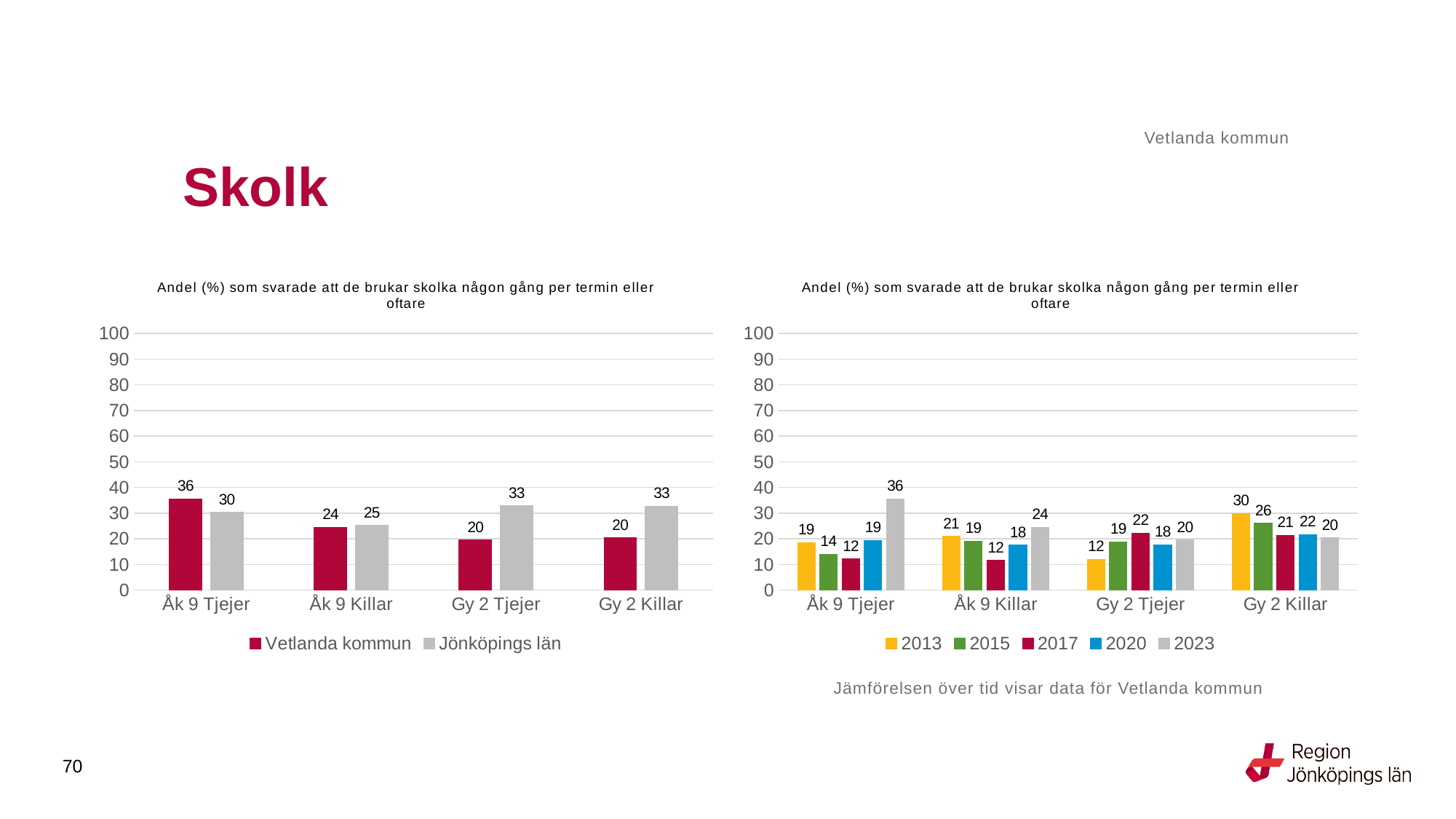
In the left chart, what is the difference between Jönköpings län and Vetlanda kommun for Gy 2 Tjejer? 13 In the left chart, which is larger for Åk 9 Tjejer: Vetlanda kommun or Jönköpings län? Vetlanda kommun In the right chart, what is the value for 2013 for Gy 2 Killar? 30 What type of chart is the right chart? Bar chart In the right chart, what is the difference between 2023 and 2017 for Åk 9 Tjejer? 24 In the left chart, what is the value for Jönköpings län for Gy 2 Killar? 33 How many series does the legend of the right chart list? 5 In the right chart, what is the value for 2023 for Åk 9 Tjejer? 36 How many categories are shown on the x axis of the left chart? 4 In the left chart, which category has the highest value for Vetlanda kommun? Åk 9 Tjejer In the right chart, which year has the lowest value for Åk 9 Killar? 2017 In the left chart, what is the value for Vetlanda kommun for Åk 9 Tjejer? 36